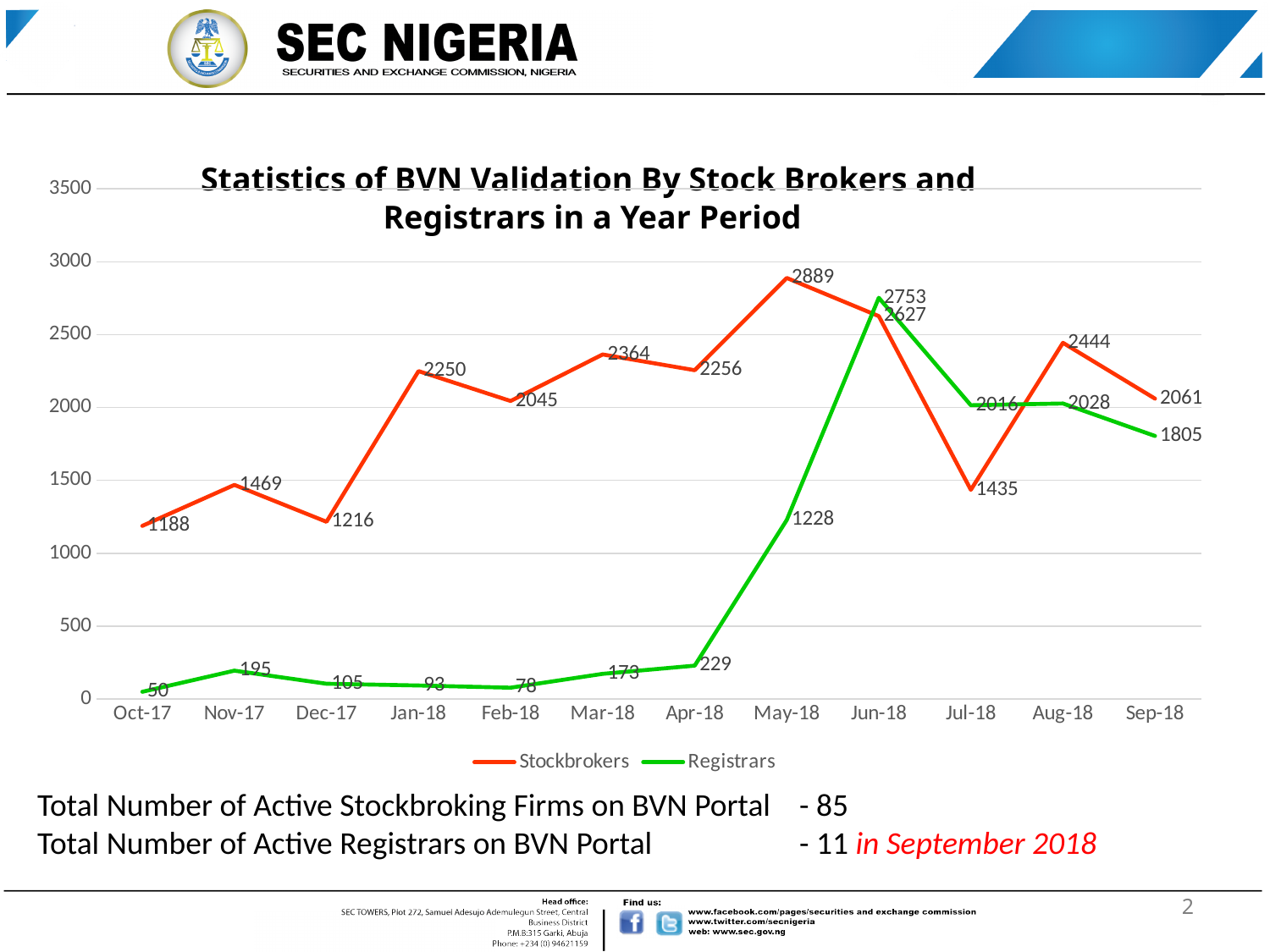
Is the Registrars value for May-18 greater or less than 1000? greater What is the Stockbrokers value for Jul-18? 1435 How many months are plotted along the x axis? 12 In Jun-18, which series has the larger value, Stockbrokers or Registrars? Registrars What is the Registrars value for Jun-18? 2753 In which month is the Stockbrokers series highest? May-18 How many series does the legend list? 2 What is the difference between the Stockbrokers values for May-18 and Jun-18? 262 Does the Registrars series rise or fall from Apr-18 to Jun-18? rise What kind of chart is shown on the slide? line chart What is the Stockbrokers value for May-18? 2889 In which month is the Registrars series lowest? Oct-17